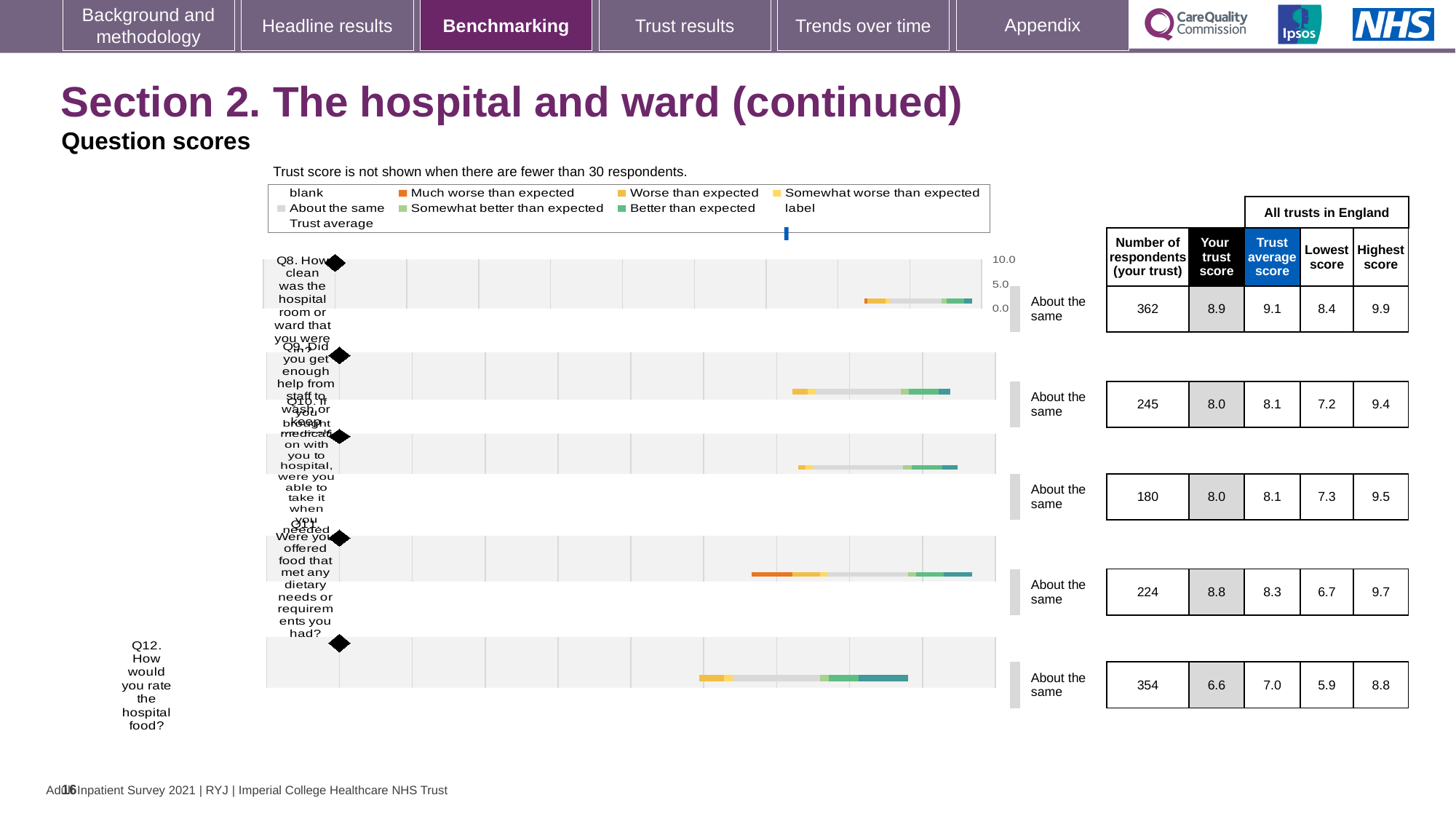
What is the 'Your trust score' for Q8 (how clean was the hospital room or ward)? 8.9 How many questions (Q8 to Q12) are plotted in the chart? 5 For Q11, which is larger: your trust score or the trust average score? Your trust score What benchmark category label is shown for Q12? About the same Which question has the lowest 'Your trust score'? Q12 What is the trust average score for Q9 (did you get enough help from staff to wash or keep yourself clean)? 8.1 What is the difference between the highest score and the lowest score across all trusts in England for Q12? 2.9 Which question has the highest 'Your trust score'? Q8 What kind of chart is used to show the question scores on this slide? bar chart What is the lowest score across all trusts in England for Q11? 6.7 How many respondents from your trust answered Q12 (how would you rate the hospital food)? 354 According to the note above the chart, when is the trust score not shown? When there are fewer than 30 respondents